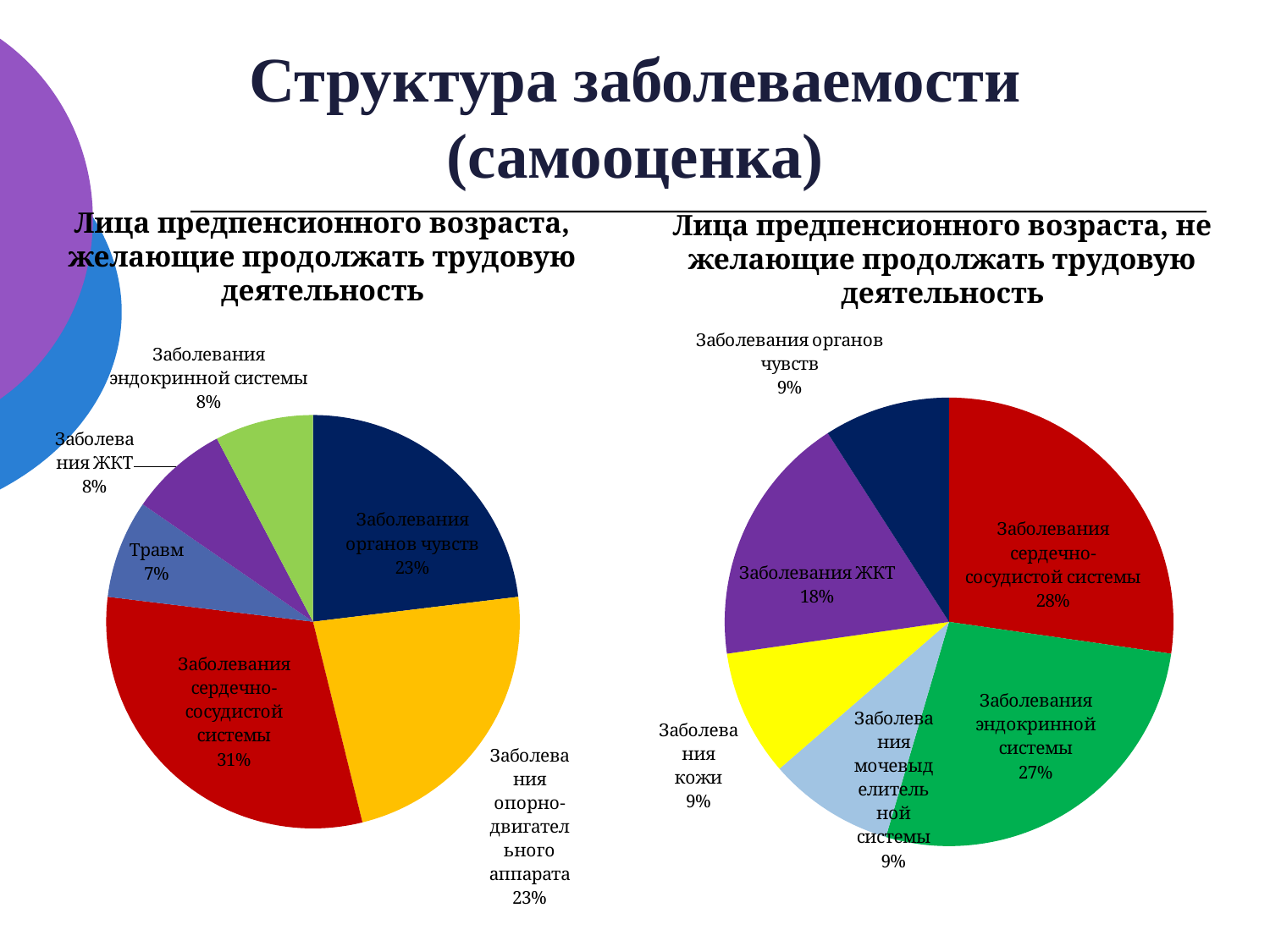
On the left pie chart (желающие продолжать трудовую деятельность), how many slices does the pie have? 6 What type of chart is used on the slide? Pie chart On the right pie chart (не желающие продолжать трудовую деятельность), which category has the largest share? Заболевания сердечно-сосудистой системы On the right pie chart (Лица предпенсионного возраста, не желающие продолжать трудовую деятельность), what share is Заболевания ЖКТ? 18% On the left pie chart (желающие продолжать трудовую деятельность), what share is Травм? 7% On the left pie chart (желающие продолжать трудовую деятельность), what is the difference between Заболевания сердечно-сосудистой системы and Заболевания органов чувств? 8% On the left pie chart (желающие продолжать трудовую деятельность), which category has the largest share? Заболевания сердечно-сосудистой системы On the right pie chart (не желающие продолжать трудовую деятельность), what is the difference between Заболевания ЖКТ and Заболевания органов чувств? 9% On the left pie chart (желающие продолжать трудовую деятельность), which category has the smallest share? Травм On the right pie chart (не желающие продолжать трудовую деятельность), which is larger: Заболевания ЖКТ or Заболевания кожи? Заболевания ЖКТ On the right pie chart (не желающие продолжать трудовую деятельность), what share is Заболевания эндокринной системы? 27% On the left pie chart (Лица предпенсионного возраста, желающие продолжать трудовую деятельность), what share is Заболевания сердечно-сосудистой системы? 31%